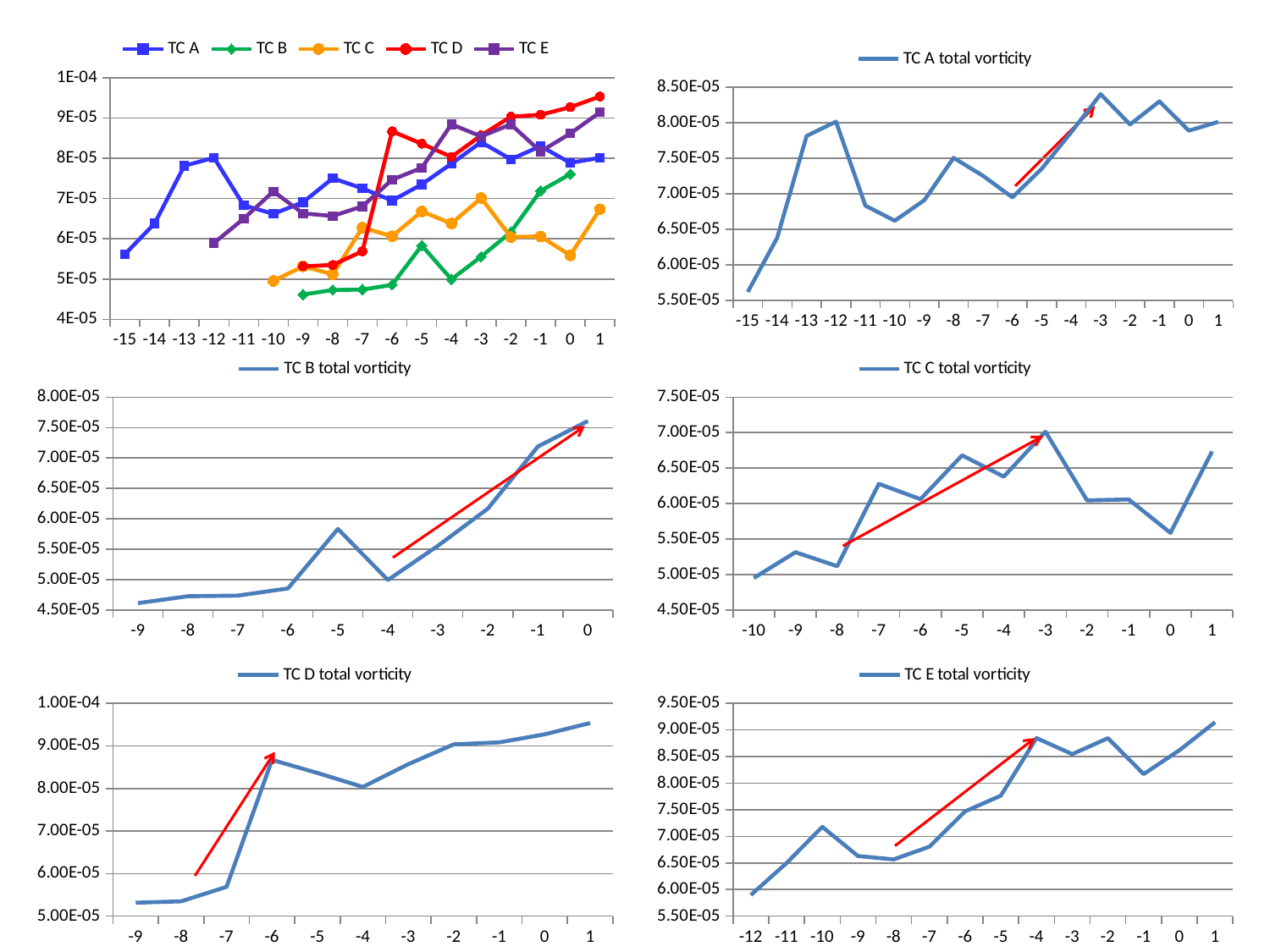
In the 'TC E total vorticity' chart, at which x value is the vorticity lowest? -12 In the top-left chart, at x = 1, which series has the larger value, TC D or TC C? TC D In the top-left chart, what colour is the TC D series? red In the 'TC C total vorticity' chart, at which x value is the vorticity highest? -3 In the top-left chart, how many series does the legend list? 5 In the 'TC B total vorticity' chart, how many points are plotted along the x axis? 10 In the 'TC E total vorticity' chart, how many x-axis categories are there? 14 What kind of chart is the 'TC A total vorticity' chart? line chart In the 'TC A total vorticity' chart, is the value at -15 greater or less than 6.00E-05? less In the 'TC B total vorticity' chart, do the values generally rise or fall from -9 to 0? rise In the 'TC D total vorticity' chart, is the value at -6 greater or less than 8.00E-05? greater In the 'TC D total vorticity' chart, at which x value is the vorticity highest? 1